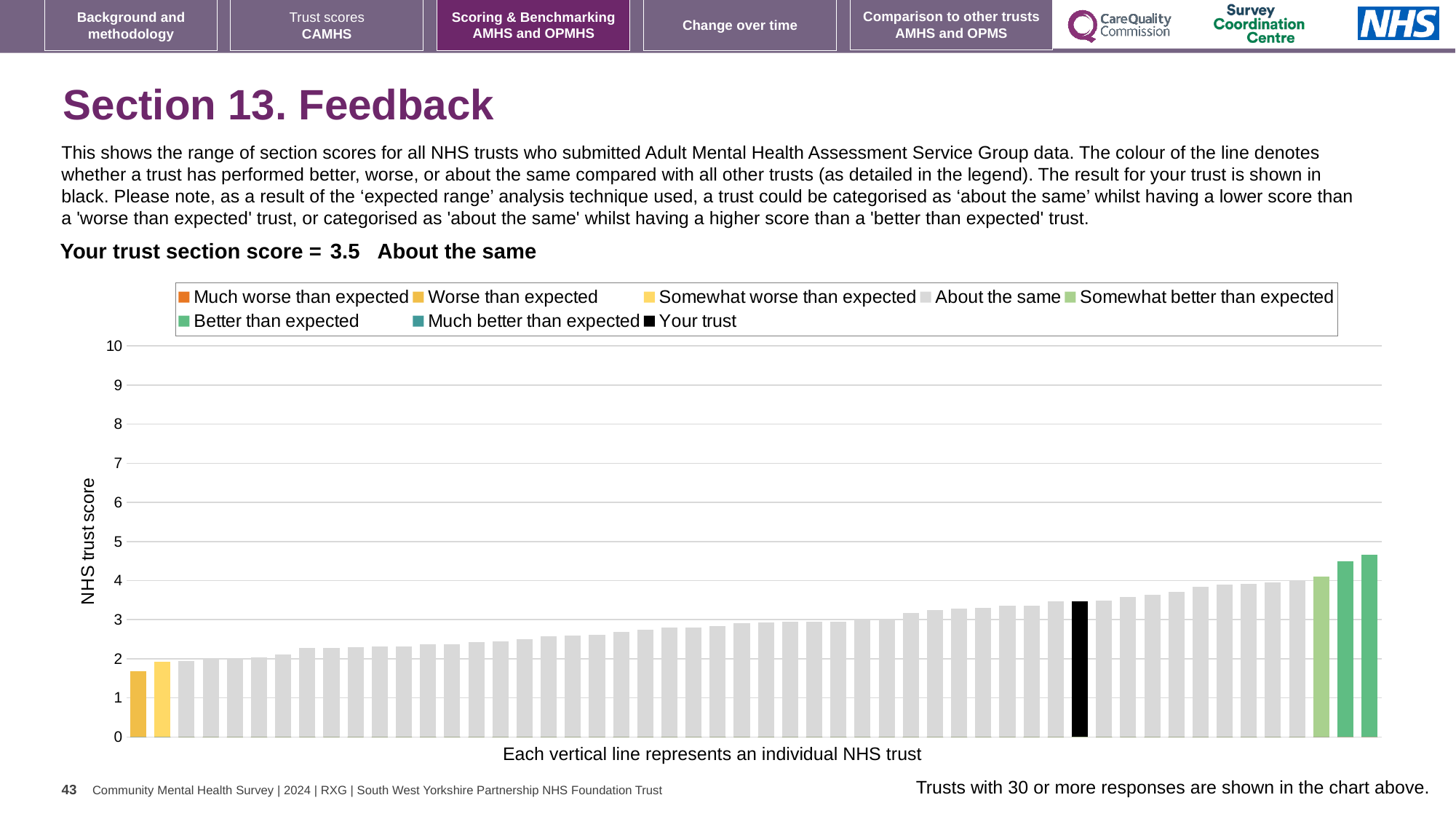
How many bars in the chart are coloured yellow (worse than expected categories)? 2 Is the value for your trust (the black bar) greater or less than 3? greater Is the value of the tallest bar in the chart greater or less than 4? greater Do the bar values rise or fall from left to right along the x axis? rise What kind of chart is shown on the slide? bar chart Is the value for your trust (the black bar) greater or less than 4? less How many entries does the chart legend list? 8 How many bars in the chart are coloured green (better than expected categories)? 3 What is the label on the vertical axis of the chart? NHS trust score What is the section score for your trust? 3.5 What colour is used for the bar representing your trust? black